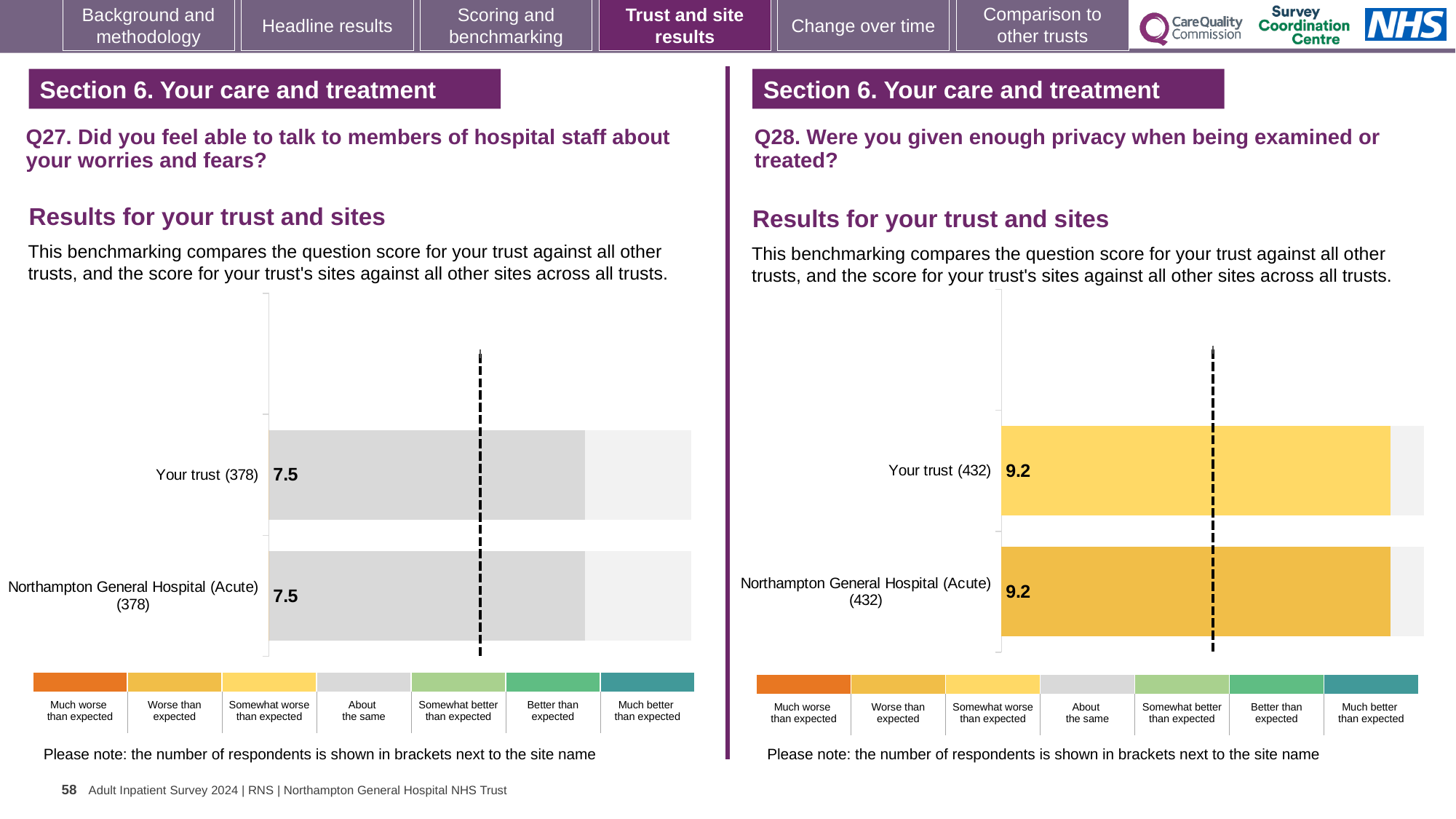
How many respondents are shown in brackets for Your trust on the Q28 chart (right)? 432 On the Q28 chart (right), what is the score for Northampton General Hospital (Acute) (432)? 9.2 How many bars are plotted on the Q28 chart (right)? 2 On the Q27 chart (left), what is the score for Your trust (378)? 7.5 How many categories does the colour key below the Q27 chart (left) list? 7 How many bars are plotted on the Q27 chart (left)? 2 What kind of chart is used on the Q27 chart (left)? Bar chart On the Q27 chart (left), what is the score for Northampton General Hospital (Acute) (378)? 7.5 On the Q28 chart (right), what is the score for Your trust (432)? 9.2 According to the colour key, which benchmark category does the grey colour of the bars on the Q27 chart (left) represent? About the same On the Q27 chart (left), what is the difference between the score for Your trust and the score for Northampton General Hospital (Acute)? 0.0 On the Q28 chart (right), what is the difference between the score for Your trust and the score for Northampton General Hospital (Acute)? 0.0